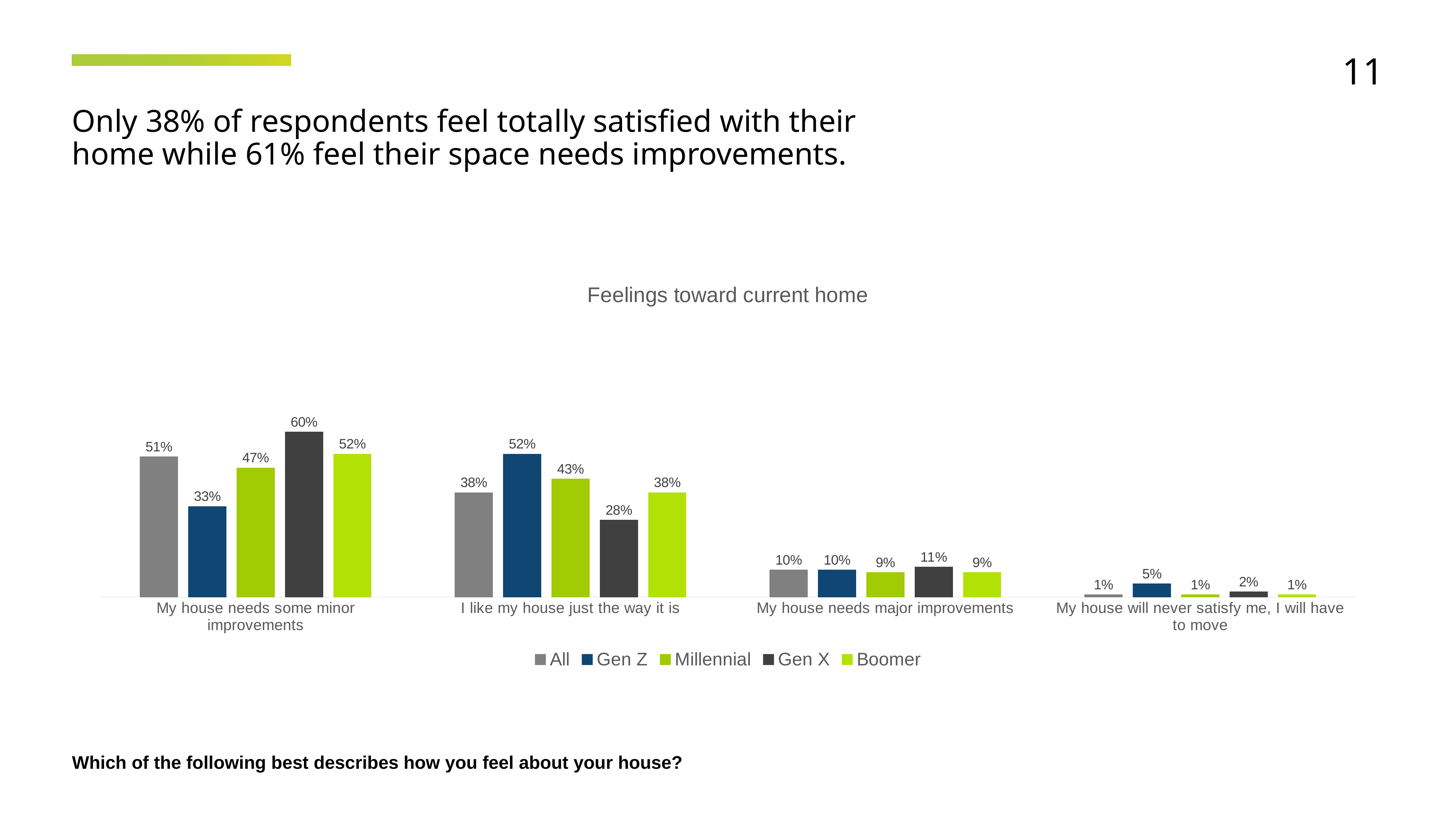
Which series has the lowest value for "I like my house just the way it is"? Gen X What kind of chart is shown on the slide? Bar chart For "I like my house just the way it is", which is larger: the Millennial value or the Boomer value? Millennial What is the Gen X value for "My house needs some minor improvements"? 60% What is the Gen Z value for "My house will never satisfy me, I will have to move"? 5% What is the Boomer value for "My house needs major improvements"? 9% What is the Gen Z value for "I like my house just the way it is"? 52% How many categories are shown on the x axis? 4 How many series does the legend list? 5 Which series has the highest value for "My house needs some minor improvements"? Gen X What is the difference between the Gen X and Gen Z values for "My house needs some minor improvements"? 27% What is the title of the chart? Feelings toward current home